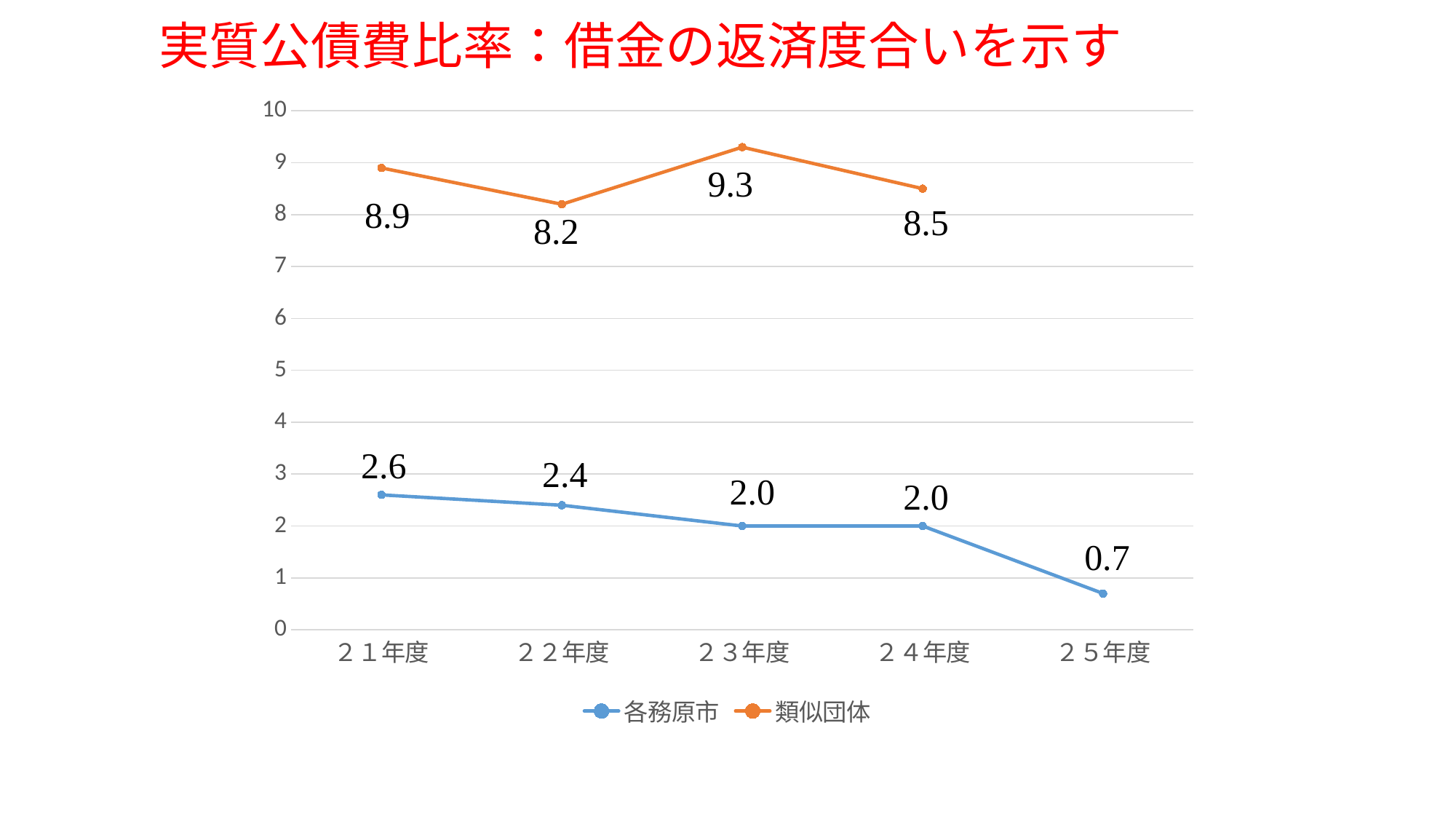
Which series has the larger value in ２１年度, 各務原市 or 類似団体? 類似団体 How many series does the legend list? 2 What kind of chart is shown on the slide? line chart What is the value for 各務原市 in ２１年度? 2.6 What is the value for 類似団体 in ２３年度? 9.3 In which year is the value for 類似団体 highest? ２３年度 What is the value for 類似団体 in ２２年度? 8.2 In which year is the value for 各務原市 lowest? ２５年度 Does the value for 各務原市 rise or fall from ２１年度 to ２５年度? fall What is the difference between 類似団体 and 各務原市 in ２４年度? 6.5 How many years are shown on the x axis? 5 What is the value for 各務原市 in ２５年度? 0.7